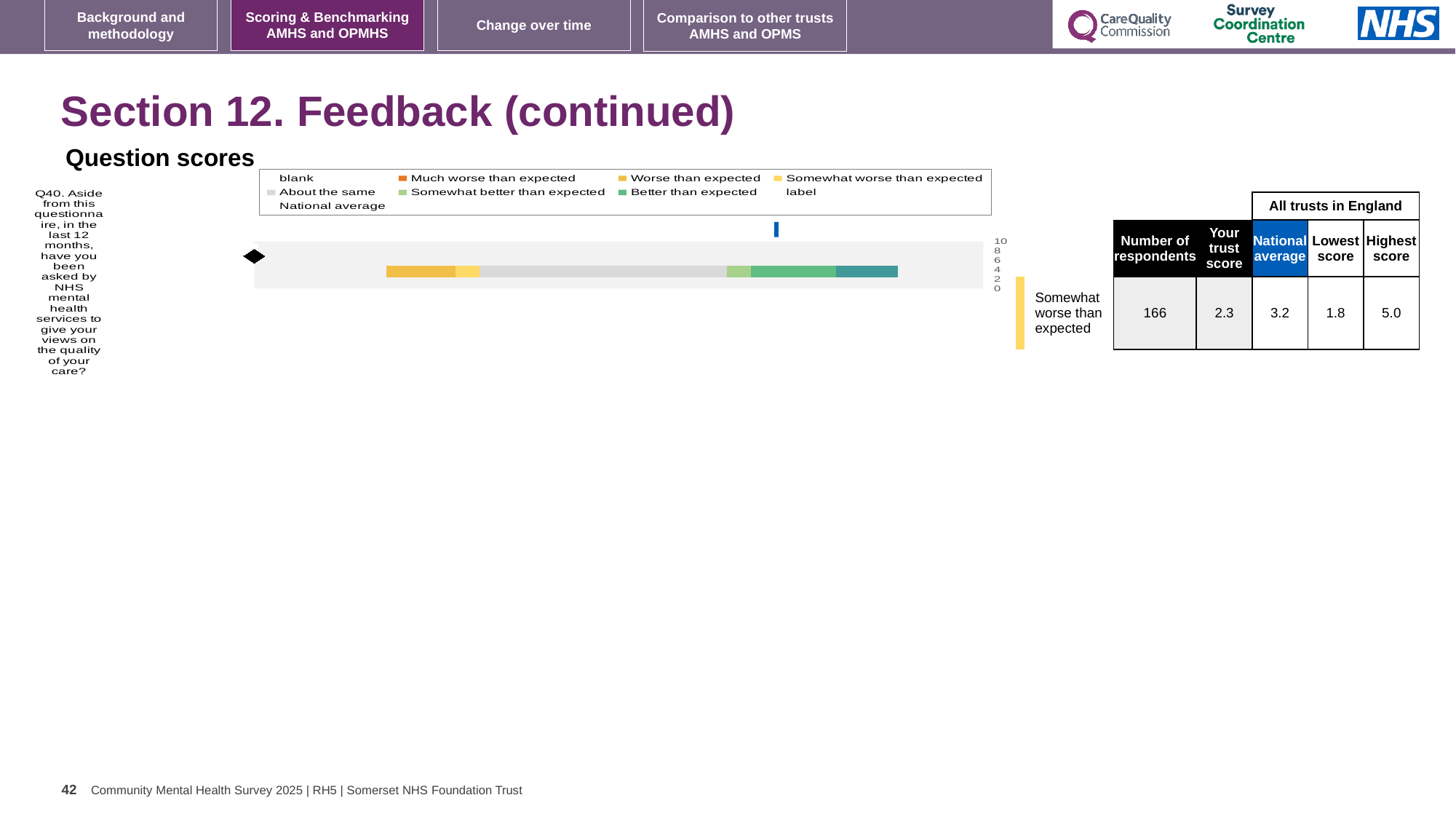
What rating label is shown to the right of the chart for Q40? Somewhat worse than expected In the table next to the chart, what is the number of respondents for Q40? 166 What is the difference between the highest score and the lowest score for Q40? 3.2 In the table next to the chart, what is the lowest score among all trusts in England for Q40? 1.8 Which question number is plotted in the chart? Q40 How many question categories are plotted in the chart? 1 In the table next to the chart, what is your trust score for Q40? 2.3 Which is larger for Q40, your trust score or the national average? national average What kind of chart is shown on the slide for Q40? bar chart In the table next to the chart, what is the national average for Q40? 3.2 In the table next to the chart, what is the highest score among all trusts in England for Q40? 5.0 What is the difference between the national average and your trust score for Q40? 0.9